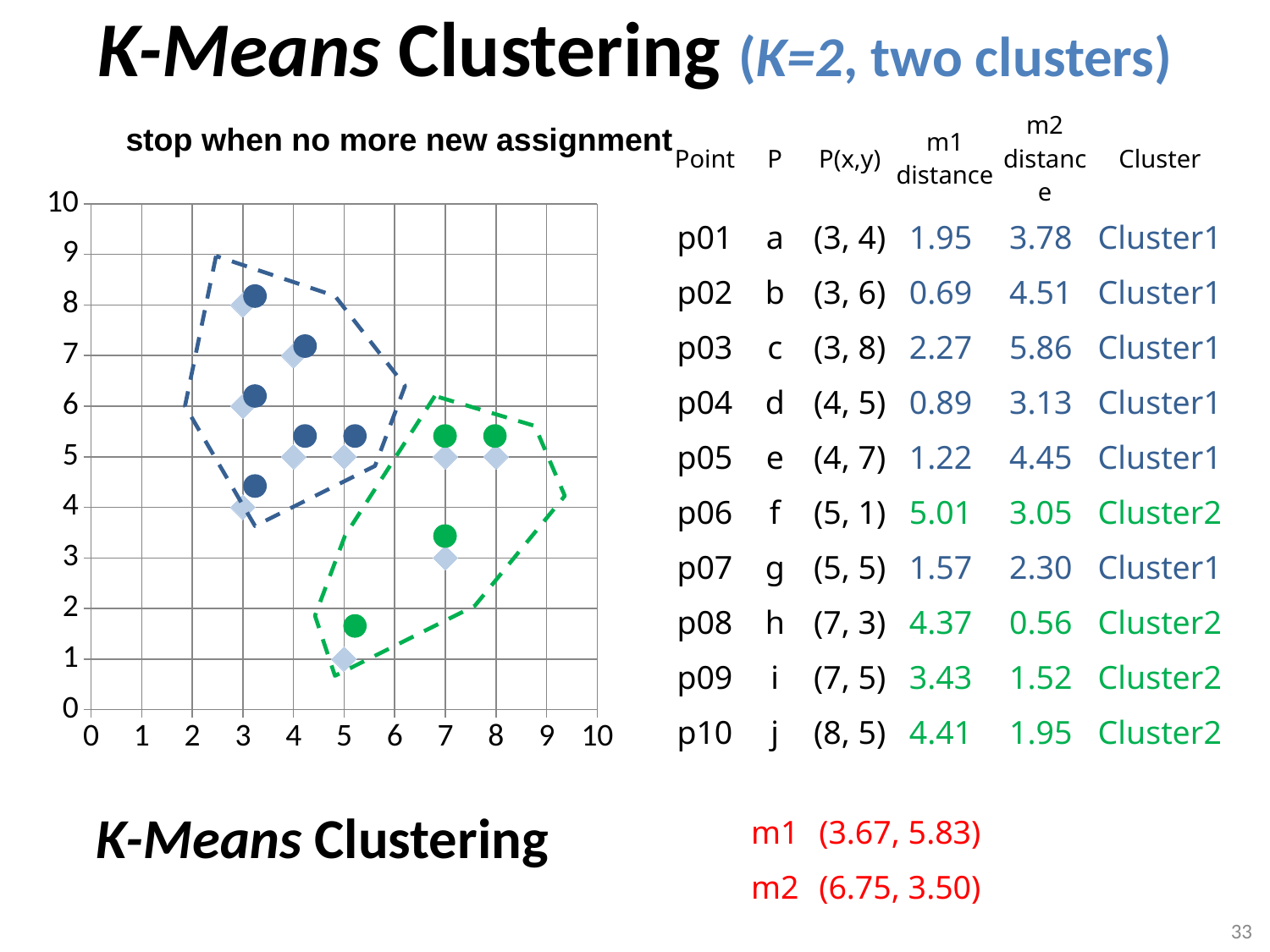
What are the coordinates of point h? (7, 3) Which point has the lowest y value in the scatter chart? f (5, 1) Which point has the highest x value in the scatter chart? j (8, 5) What are the coordinates of point e? (4, 7) How many points are enclosed in the green dashed cluster (Cluster2)? 4 Is the y value of point f greater or less than 2? less Which point has the highest y value in the scatter chart? c (3, 8) Which has the larger y value, point c or point j? point c What is the maximum value shown on the x axis of the scatter chart? 10 What is the maximum value shown on the y axis of the scatter chart? 10 How many data points are plotted in the scatter chart? 10 What kind of chart is shown on the left of the slide? scatter chart